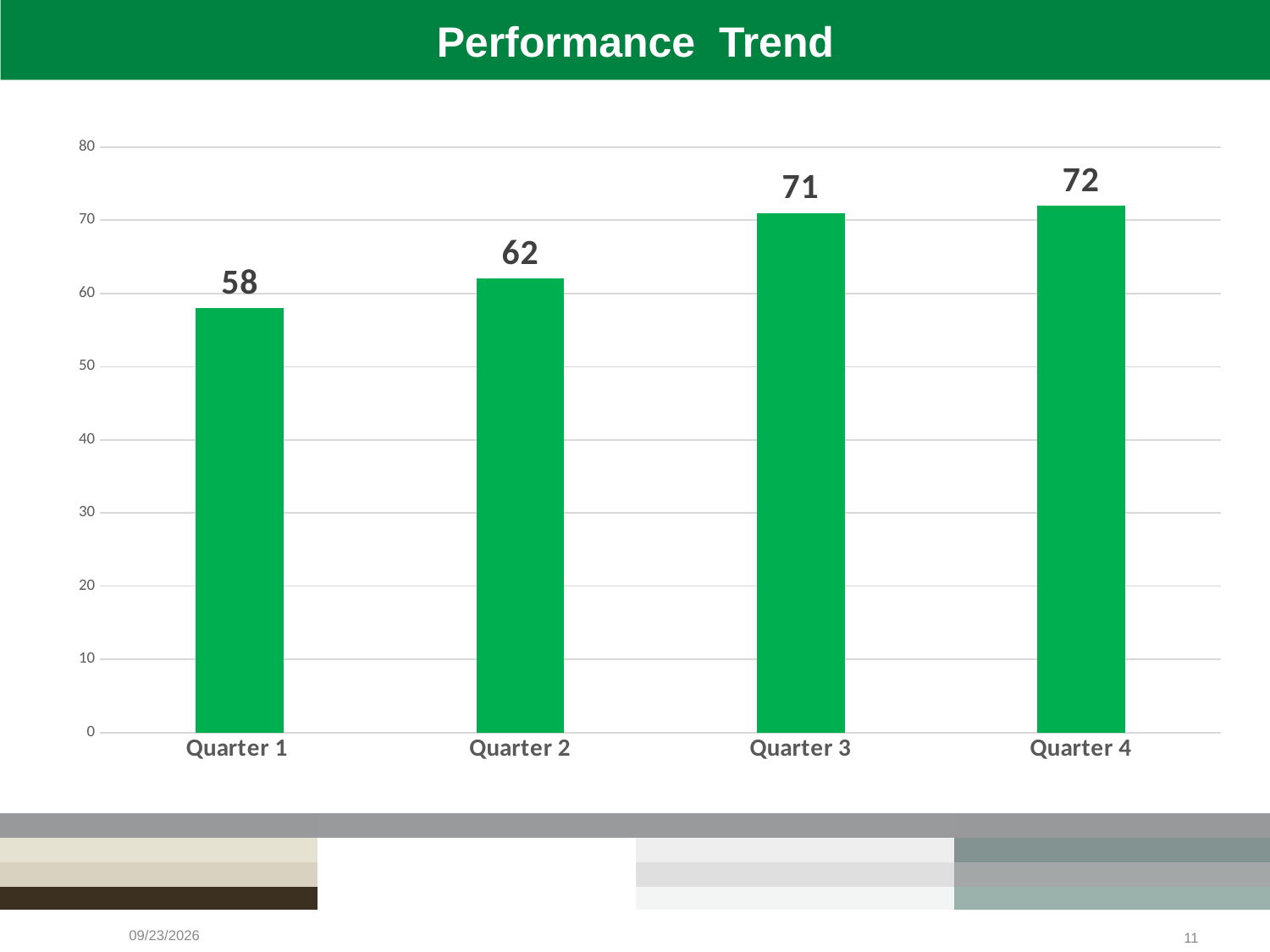
How many quarters are shown on the chart? 4 Which quarter has the highest value? Quarter 4 What is the difference between the values for Quarter 4 and Quarter 1? 14 Do the values rise or fall from Quarter 1 to Quarter 4? rise Which quarter has the lowest value? Quarter 1 What is the value for Quarter 1? 58 What is the title of the slide? Performance Trend What kind of chart is shown on the slide? bar chart Which is larger, the value for Quarter 2 or the value for Quarter 3? Quarter 3 What is the difference between the values for Quarter 2 and Quarter 1? 4 What is the value for Quarter 3? 71 Is the value for Quarter 2 greater or less than 70? less